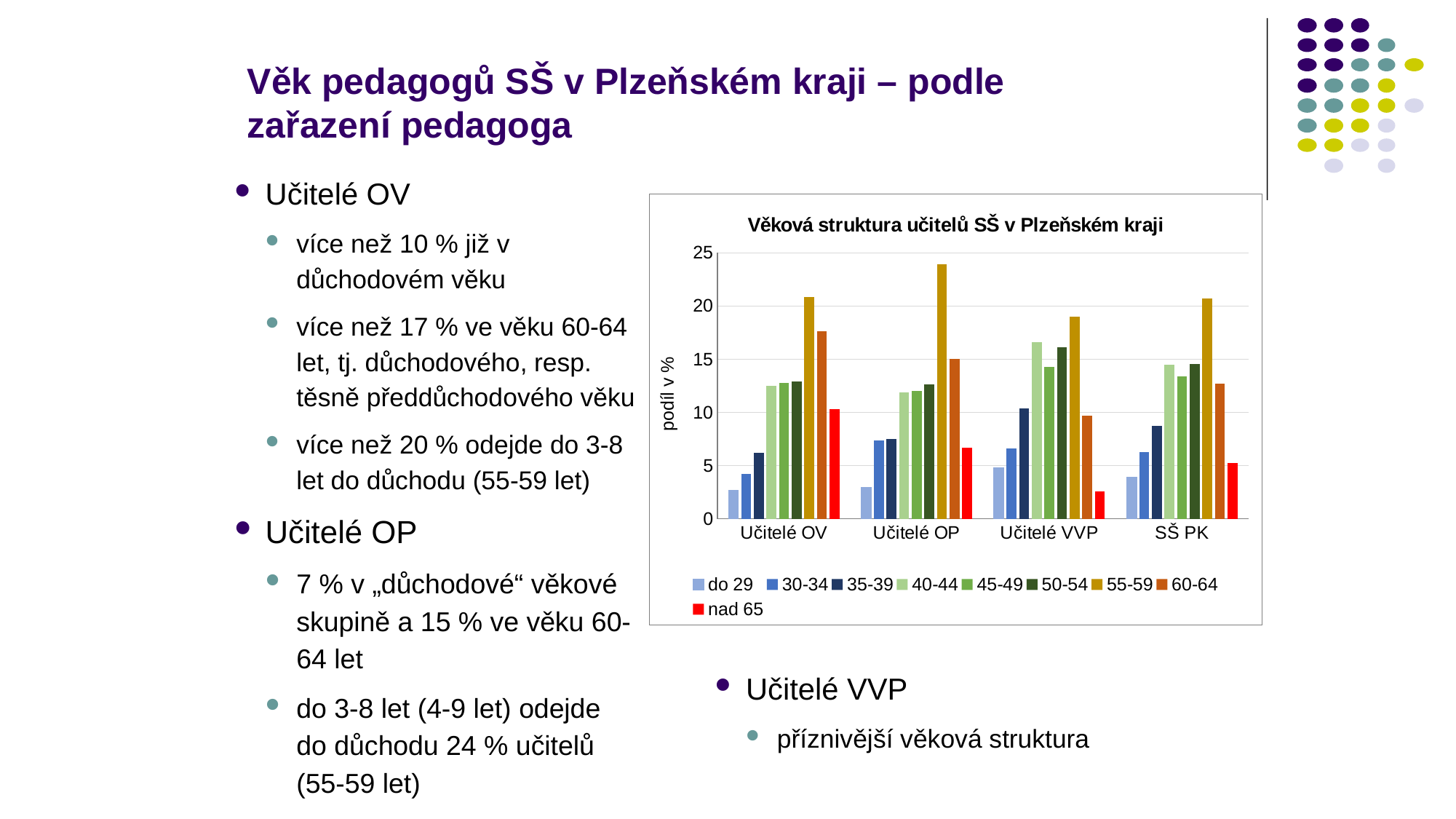
Within the Učitelé VVP category, which age group has the highest bar? 55-59 Is the value for the 55-59 series in Učitelé OP greater or less than 20? greater Is the value for the 60-64 series in Učitelé OV greater or less than 15? greater Which category has the lowest value for the nad 65 series? Učitelé VVP How many categories are shown on the x axis of the chart? 4 Which is larger, the 60-64 value for Učitelé OV or for Učitelé OP? Učitelé OV What kind of chart is shown on the slide? bar chart Which category has the highest value for the 55-59 series? Učitelé OP What is the title of the chart? Věková struktura učitelů SŠ v Plzeňském kraji What is the label of the y axis of the chart? podíl v % Is the value for the nad 65 series in Učitelé VVP greater or less than 5? less How many series does the chart legend list? 9